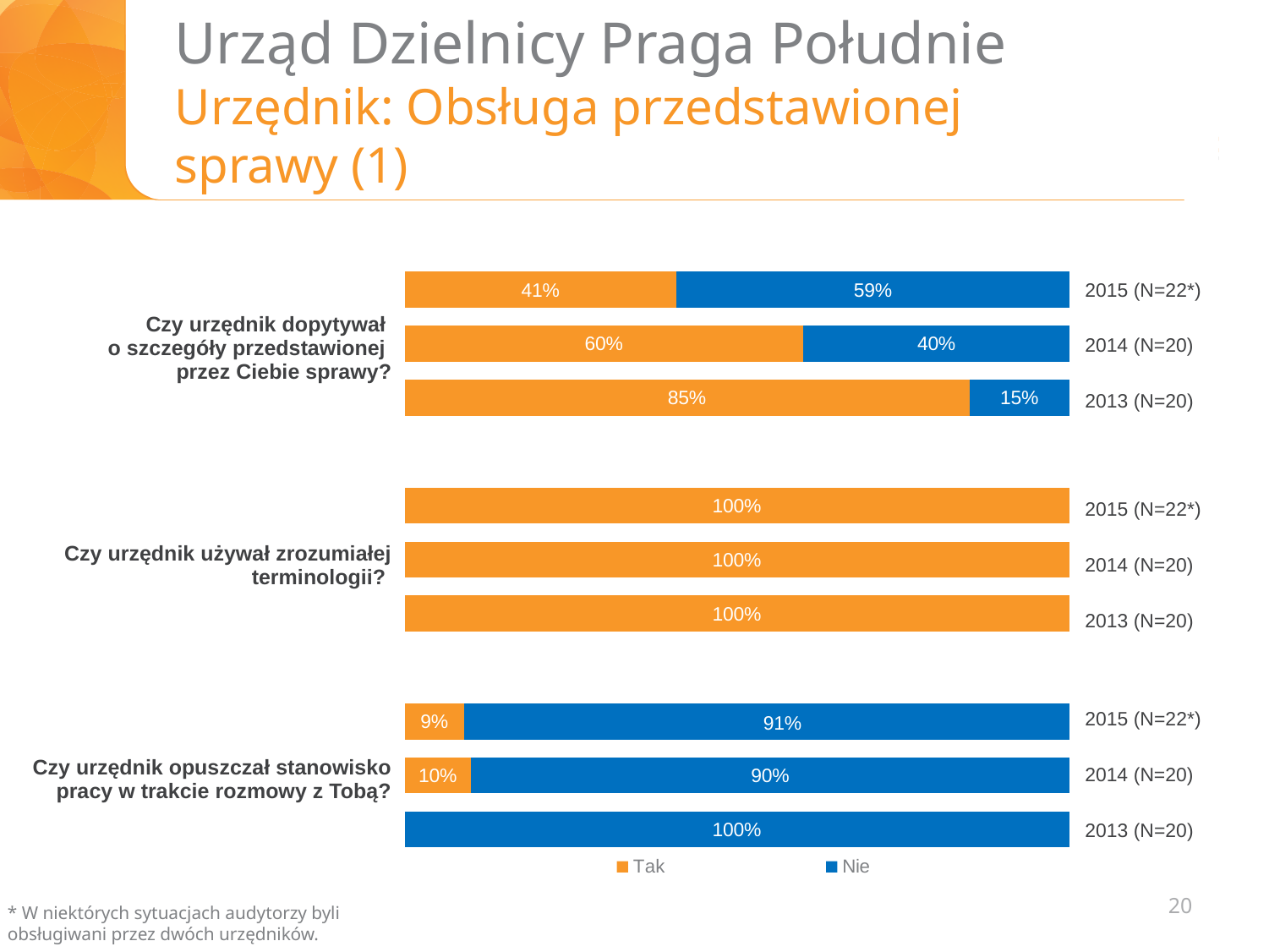
What kind of chart is shown on the slide? stacked bar chart What is the 'Tak' value for 2014 (N=20) for the question 'Czy urzędnik używał zrozumiałej terminologii?' 100% What is the 'Nie' value for 2014 (N=20) for the question 'Czy urzędnik dopytywał o szczegóły przedstawionej przez Ciebie sprawy?' 40% What is the 'Tak' value for 2015 (N=22*) for the question 'Czy urzędnik dopytywał o szczegóły przedstawionej przez Ciebie sprawy?' 41% For the question 'Czy urzędnik dopytywał o szczegóły przedstawionej przez Ciebie sprawy?', which year has the highest 'Tak' share? 2013 (N=20) For the question 'Czy urzędnik dopytywał o szczegóły przedstawionej przez Ciebie sprawy?', how does the 'Tak' share change from 2013 to 2015? It falls What are the two legend entries? Tak, Nie For the question 'Czy urzędnik opuszczał stanowisko pracy w trakcie rozmowy z Tobą?', which is larger: the 'Tak' value for 2014 (N=20) or the 'Tak' value for 2015 (N=22*)? 2014 (N=20) What is the difference between the 'Tak' values for 2013 (N=20) and 2015 (N=22*) for the question 'Czy urzędnik dopytywał o szczegóły przedstawionej przez Ciebie sprawy?' 44% What is the 'Nie' value for 2015 (N=22*) for the question 'Czy urzędnik opuszczał stanowisko pracy w trakcie rozmowy z Tobą?' 91% How many series does the legend list? 2 What is the 'Tak' value for 2013 (N=20) for the question 'Czy urzędnik dopytywał o szczegóły przedstawionej przez Ciebie sprawy?' 85%